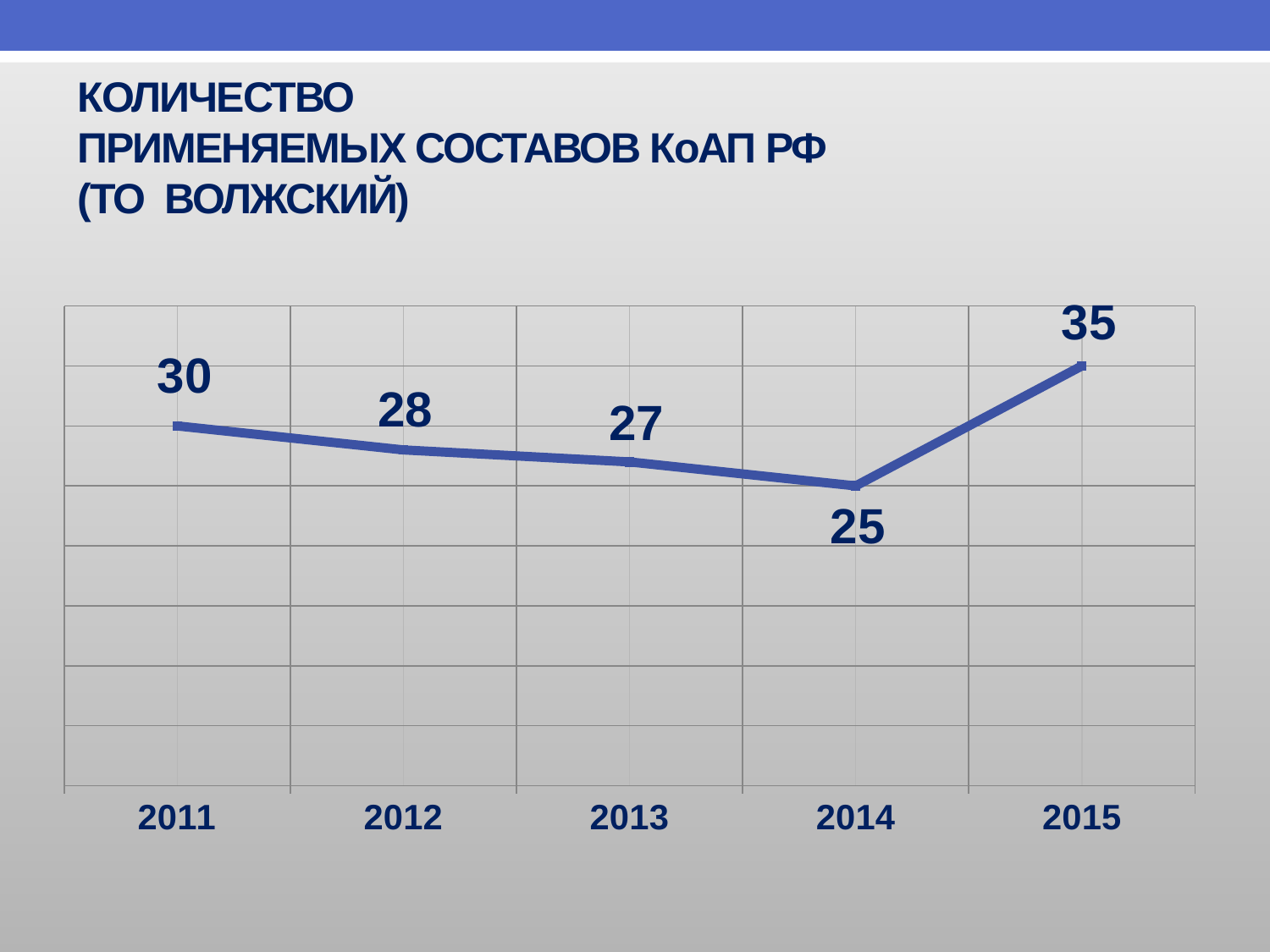
Which year has the lowest value? 2014 What is the value for 2015? 35 What is the difference between the values for 2015 and 2014? 10 What is the value for 2011? 30 What is the value for 2014? 25 What kind of chart is shown on the slide? line chart Which is larger, the value for 2012 or the value for 2013? 2012 Do the values rise or fall from 2011 to 2014? fall What is the difference between the values for 2011 and 2012? 2 How many years are plotted on the chart? 5 Which year has the highest value? 2015 What is the value for 2013? 27